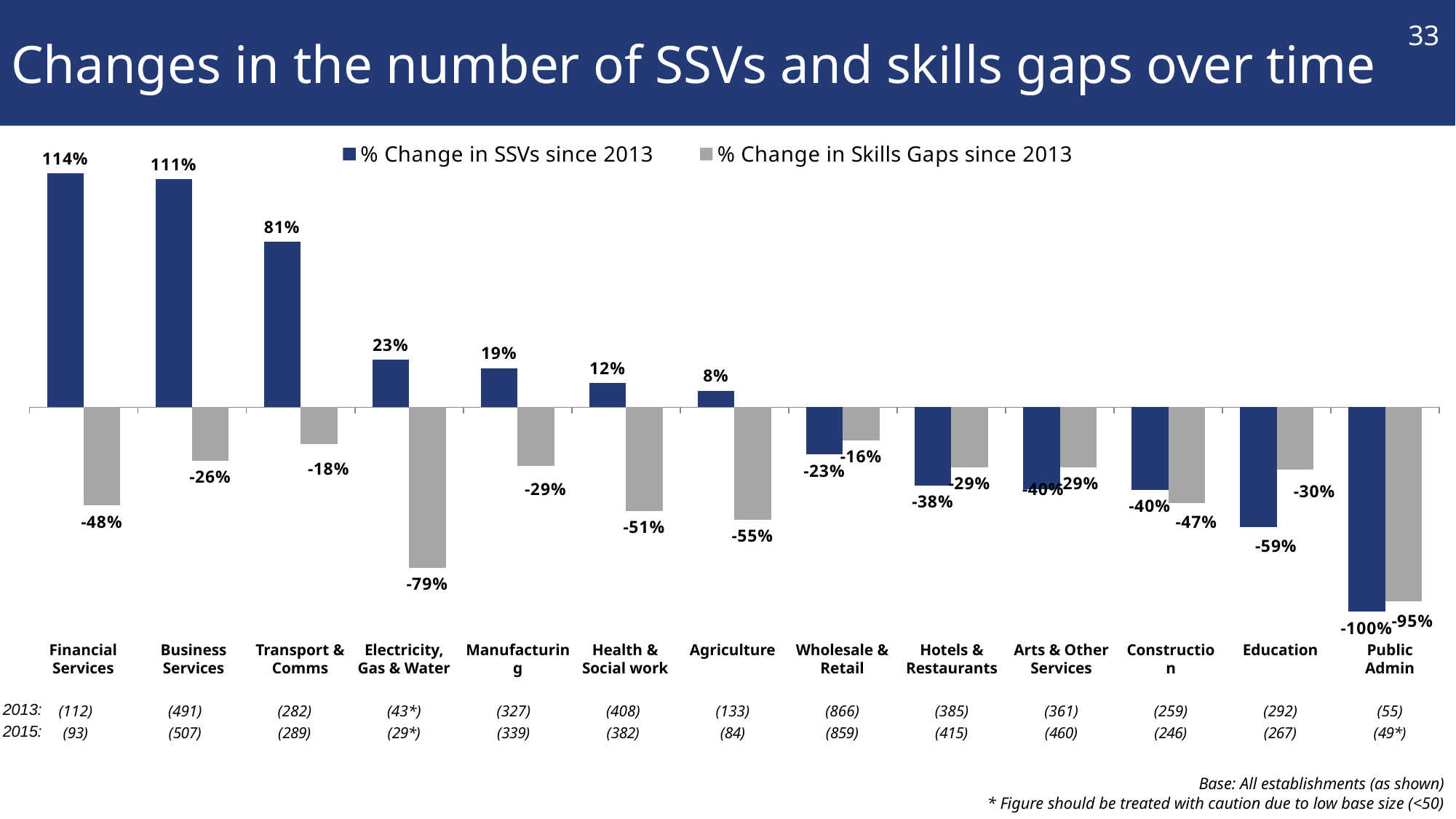
What colour are the bars for % Change in SSVs since 2013? Dark blue What is the difference between the % change in SSVs for Financial Services and Transport & Comms? 33 percentage points What is the % change in Skills Gaps since 2013 for Agriculture? -55% How many series does the legend list? 2 Which sector has the highest % change in SSVs since 2013? Financial Services What is the % change in Skills Gaps since 2013 for Electricity, Gas & Water? -79% What is the % change in SSVs since 2013 for Financial Services? 114% What is the % change in SSVs since 2013 for Education? -59% Which sector has the lowest % change in Skills Gaps since 2013? Public Admin Which is larger: the % change in Skills Gaps for Health & Social work or for Manufacturing? Manufacturing How many sectors are shown on the chart? 13 What kind of chart is shown on the slide? Bar chart